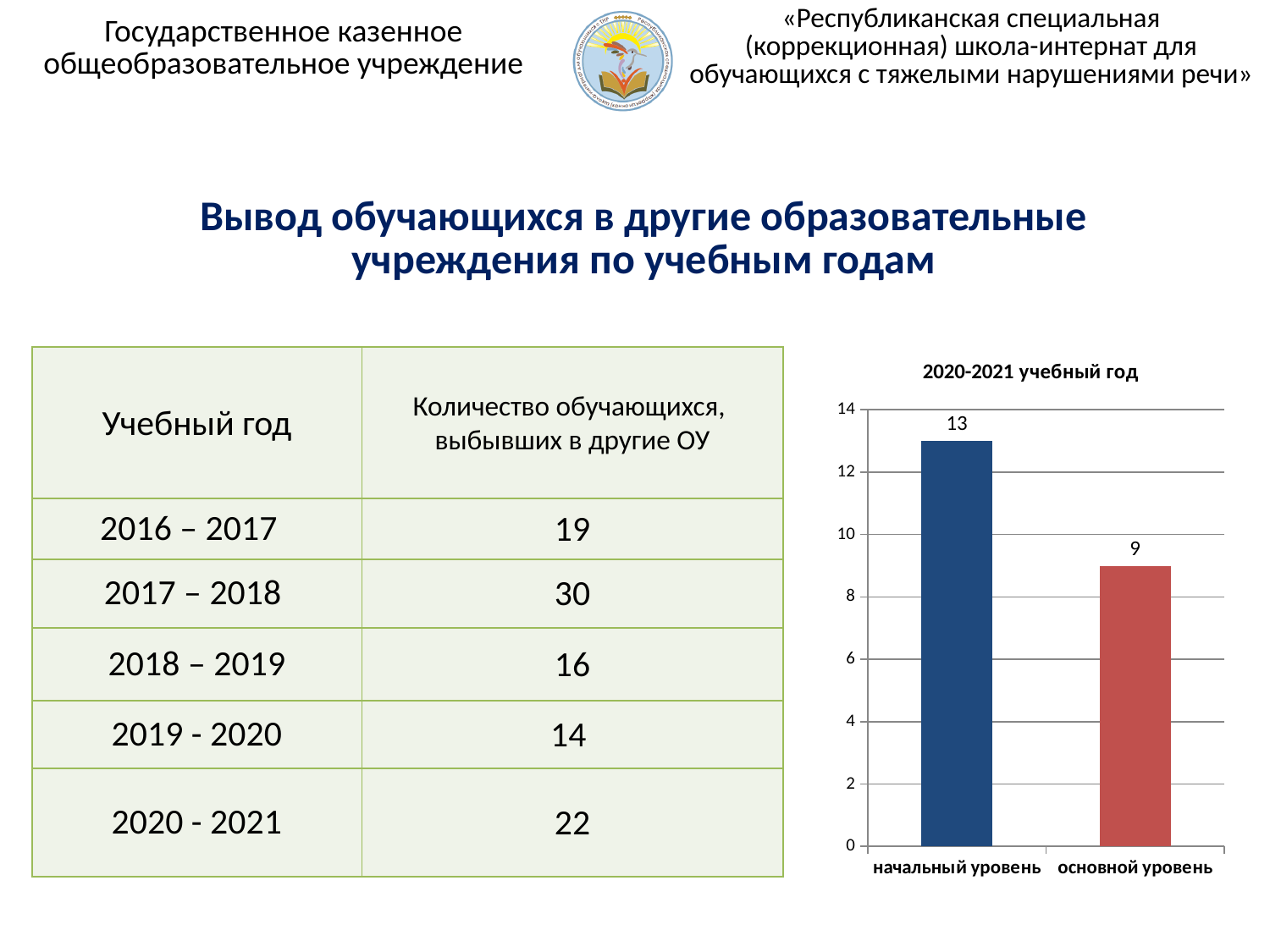
Which category has the highest value in the chart? начальный уровень What kind of chart is shown on the slide? bar chart What is the difference between the values for начальный уровень and основной уровень? 4 What is the title of the chart? 2020-2021 учебный год What is the total of the two bars in the chart? 22 Which is larger: the value for начальный уровень or the value for основной уровень? начальный уровень Is the value for начальный уровень greater or less than 12? greater How many categories are shown in the chart? 2 What is the value for начальный уровень in the chart? 13 Is the value for основной уровень greater or less than 10? less What is the value for основной уровень in the chart? 9 Which category has the lowest value in the chart? основной уровень